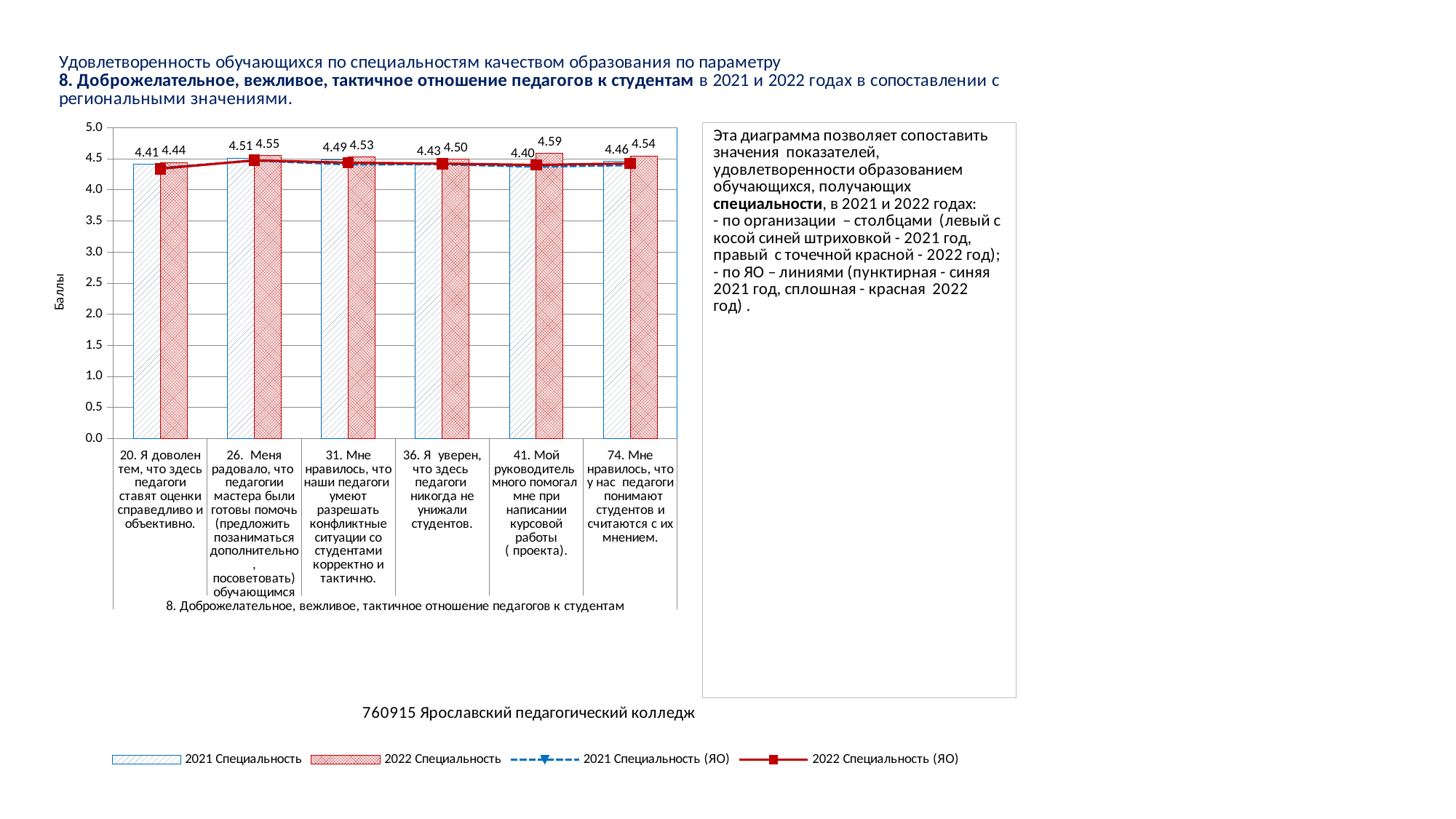
What is the difference between the 2022 and 2021 Специальность bar values for item 41? 0.19 What is the difference between the 2022 and 2021 Специальность bar values for item 31? 0.04 Which item has the highest 2022 Специальность bar value? 41. Мой руководитель много помогал мне при написании курсовой работы (проекта). Is the 2021 Специальность bar value for item 36 greater or less than 4.0? greater How many series does the chart legend list? 4 What is the value of the 2022 Специальность bar for item 74 (Мне нравилось, что у нас педагоги понимают студентов и считаются с их мнением)? 4.54 What is the label of the vertical axis of the chart? Баллы What is the value of the 2022 Специальность bar for item 41 (Мой руководитель много помогал мне при написании курсовой работы)? 4.59 For item 26, which is larger: the 2021 Специальность bar or the 2022 Специальность bar? 2022 Специальность Which item has the lowest 2021 Специальность bar value? 41. Мой руководитель много помогал мне при написании курсовой работы (проекта). How many items (categories) are shown on the x axis of the chart? 6 What is the value of the 2021 Специальность bar for item 20 (Я доволен тем, что здесь педагоги ставят оценки справедливо и объективно)? 4.41